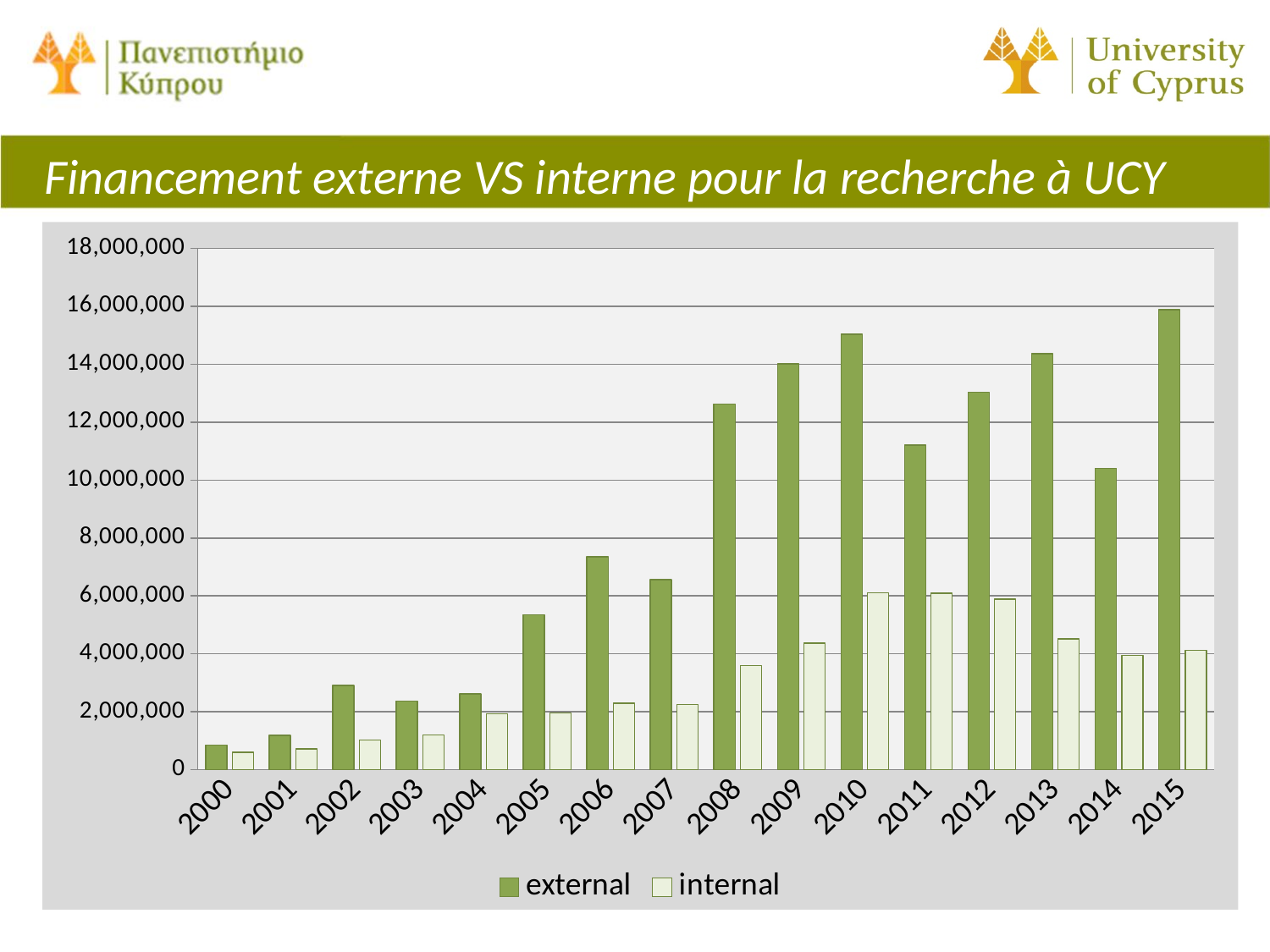
Is the external funding for 2006 greater or less than 8,000,000? less Is the internal funding for 2008 greater or less than 4,000,000? less How many years are shown on the x axis? 16 Which is larger, the external funding for 2011 or for 2012? 2012 Which year has the highest external funding? 2015 Is the internal funding for 2013 greater or less than 4,000,000? greater Overall, does external funding rise or fall from 2000 to 2015? rise What kind of chart is shown on the slide? bar chart How many series does the legend list? 2 Which year has the lowest internal funding? 2000 Which year has the lowest external funding? 2000